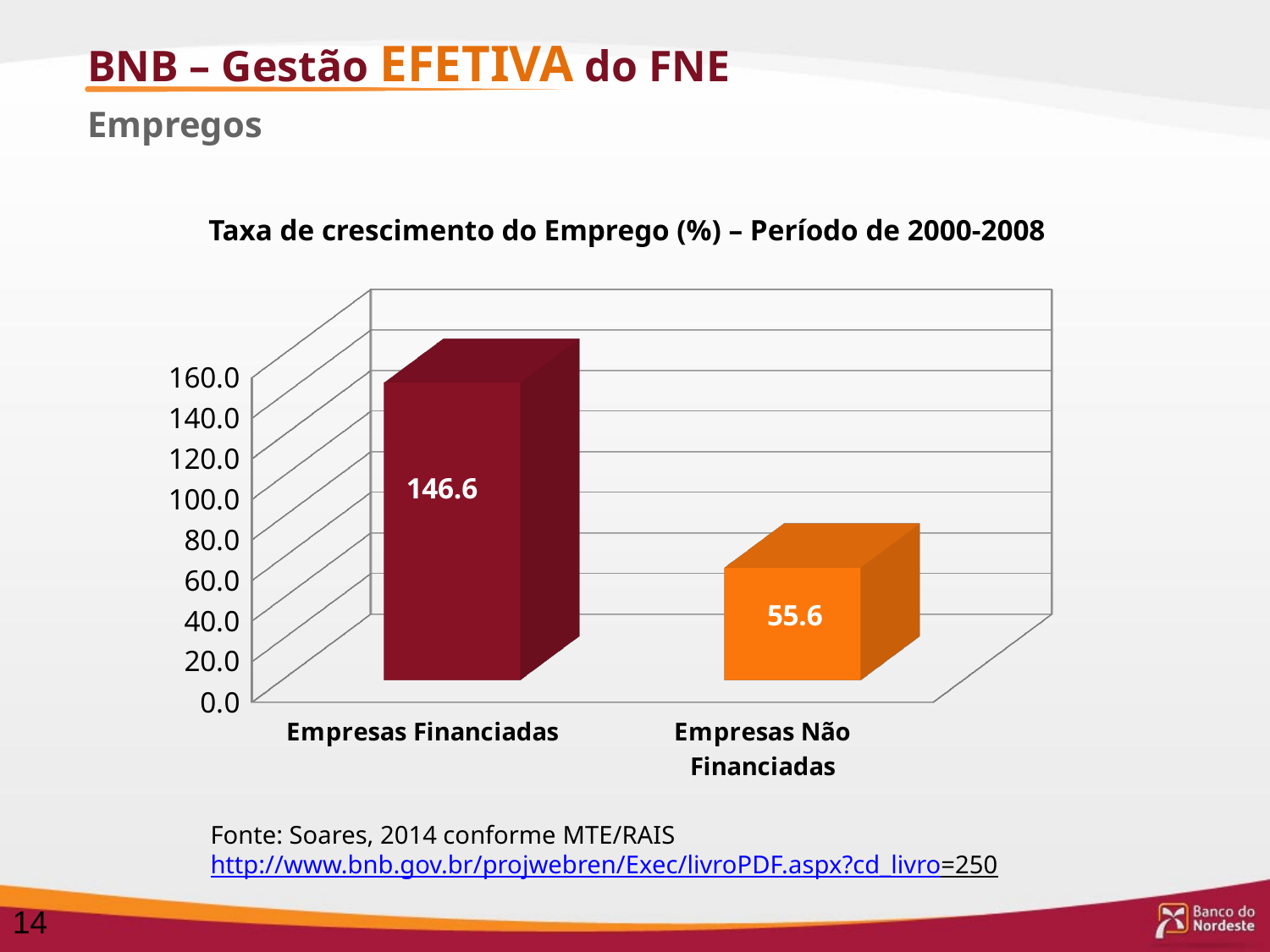
What is the difference between the values for Empresas Financiadas and Empresas Não Financiadas? 91.0 Which category has the lowest value? Empresas Não Financiadas Is the value for Empresas Financiadas greater or less than 140.0? greater What colour is the bar for Empresas Não Financiadas? orange What is the value for Empresas Não Financiadas? 55.6 What kind of chart is shown on the slide? bar chart Which is larger, the value for Empresas Financiadas or the value for Empresas Não Financiadas? Empresas Financiadas What is the value for Empresas Financiadas? 146.6 What is the title of the chart? Taxa de crescimento do Emprego (%) – Período de 2000-2008 Which category has the highest value? Empresas Financiadas How many categories are shown in the chart? 2 Is the value for Empresas Não Financiadas greater or less than 60.0? less